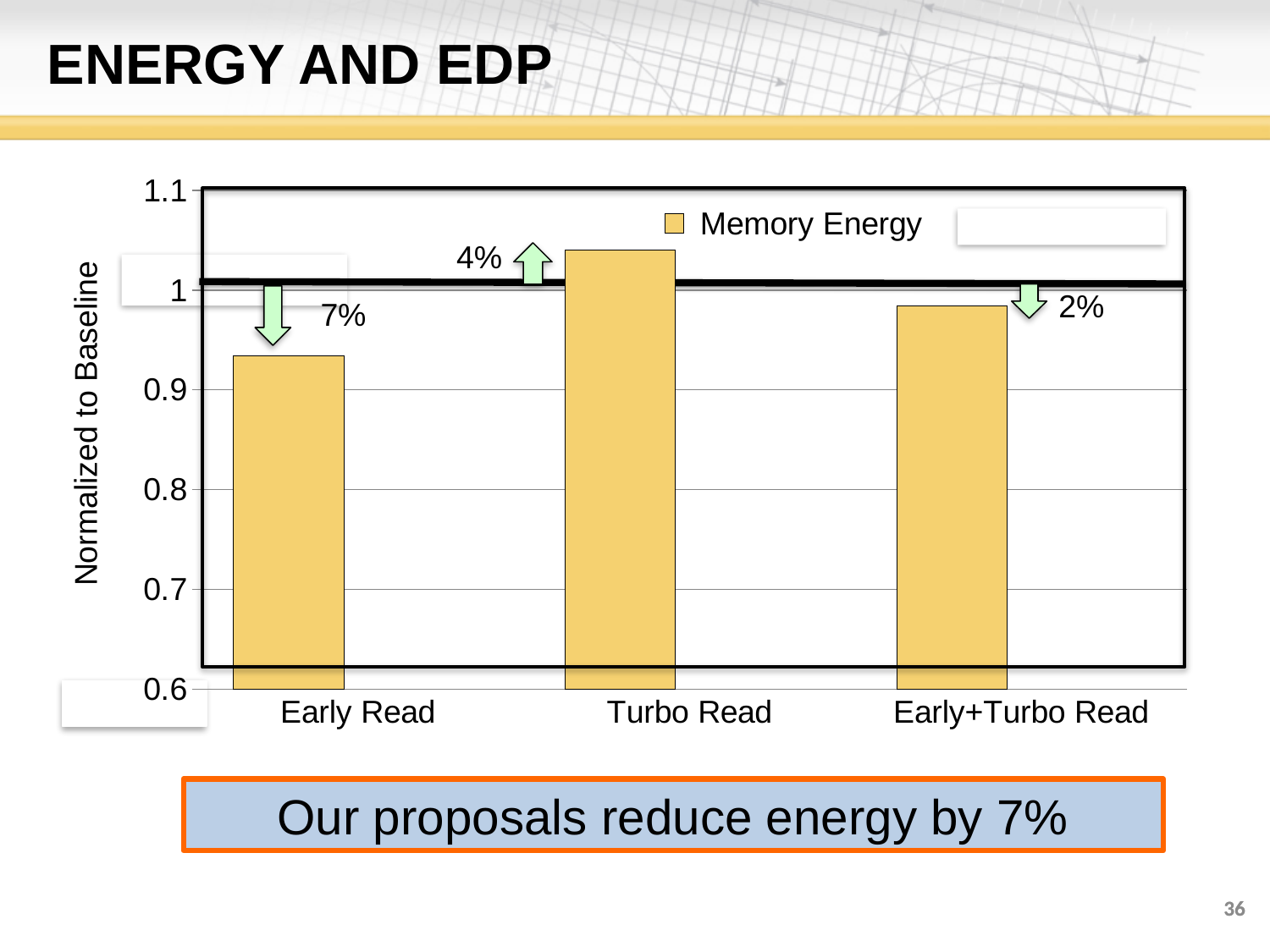
Which category has the highest Memory Energy value? Turbo Read What percentage change is annotated next to the Early Read bar? 7% Is the Memory Energy value for Early+Turbo Read greater or less than 0.9? greater Which has the larger Memory Energy value, Early Read or Turbo Read? Turbo Read What is the title of the y axis of the chart? Normalized to Baseline Which has the larger Memory Energy value, Early Read or Early+Turbo Read? Early+Turbo Read How many categories are shown on the x axis of the chart? 3 Is the Memory Energy value for Turbo Read greater or less than 1? greater Is the Memory Energy value for Early Read greater or less than 1? less What percentage change is annotated next to the Turbo Read bar? 4% Which category has the lowest Memory Energy value? Early Read What kind of chart is shown on the slide? bar chart